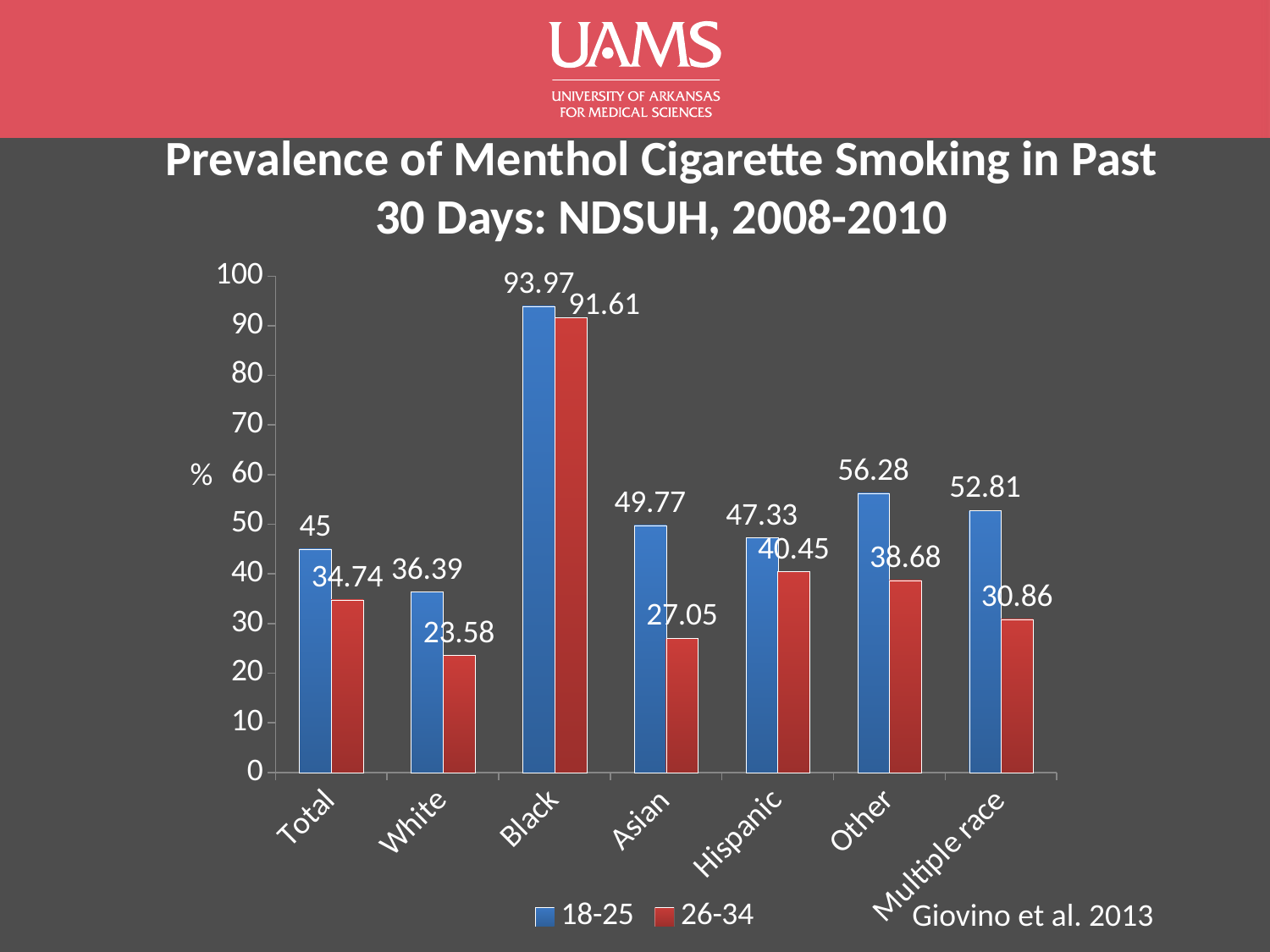
What is the value for the 18-25 series for Black? 93.97 Which is larger for Other: the 18-25 value or the 26-34 value? 18-25 What is the value for the 26-34 series for Hispanic? 40.45 What is the value for the 18-25 series for Multiple race? 52.81 What is the value for the 26-34 series for White? 23.58 Which category has the lowest value for the 26-34 series? White What is the source cited at the bottom right of the chart? Giovino et al. 2013 What kind of chart is shown on the slide? Bar chart Which category has the highest value for the 18-25 series? Black How many categories are shown on the x axis? 7 How many series does the legend list? 2 What is the difference between the 18-25 and 26-34 values for Asian? 22.72